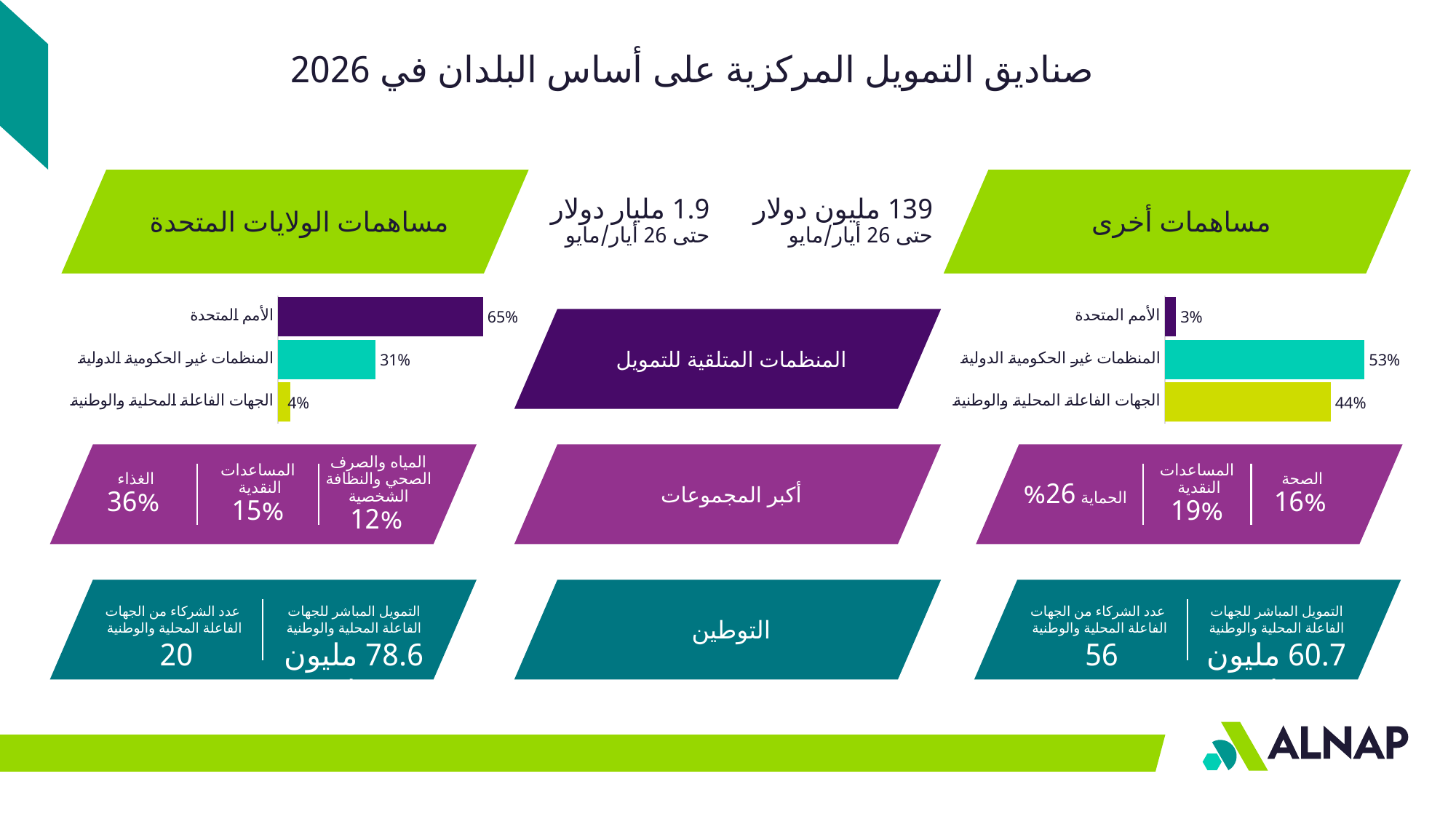
In the left chart (مساهمات الولايات المتحدة), which category has the highest percentage? الأمم المتحدة In the left chart (مساهمات الولايات المتحدة), what percentage is shown for الأمم المتحدة (United Nations)? 65% What type of chart is used on the left and right sides of the slide? bar chart In the right chart (مساهمات أخرى), what is the difference in percentage points between المنظمات غير الحكومية الدولية and الجهات الفاعلة المحلية والوطنية? 9 In the left chart (مساهمات الولايات المتحدة), what percentage is shown for الجهات الفاعلة المحلية والوطنية (local and national actors)? 4% In the left chart (مساهمات الولايات المتحدة), what percentage is shown for المنظمات غير الحكومية الدولية (international NGOs)? 31% In the right chart (مساهمات أخرى), what percentage is shown for المنظمات غير الحكومية الدولية (international NGOs)? 53% In the left chart (مساهمات الولايات المتحدة), what is the difference in percentage points between الأمم المتحدة and المنظمات غير الحكومية الدولية? 34 In the right chart (مساهمات أخرى), which category has the lowest percentage? الأمم المتحدة How many categories does each of the two bar charts show? 3 Which is larger: the share for الجهات الفاعلة المحلية والوطنية in the left chart or in the right chart? the right chart (مساهمات أخرى) In the right chart (مساهمات أخرى), what percentage is shown for الجهات الفاعلة المحلية والوطنية (local and national actors)? 44%